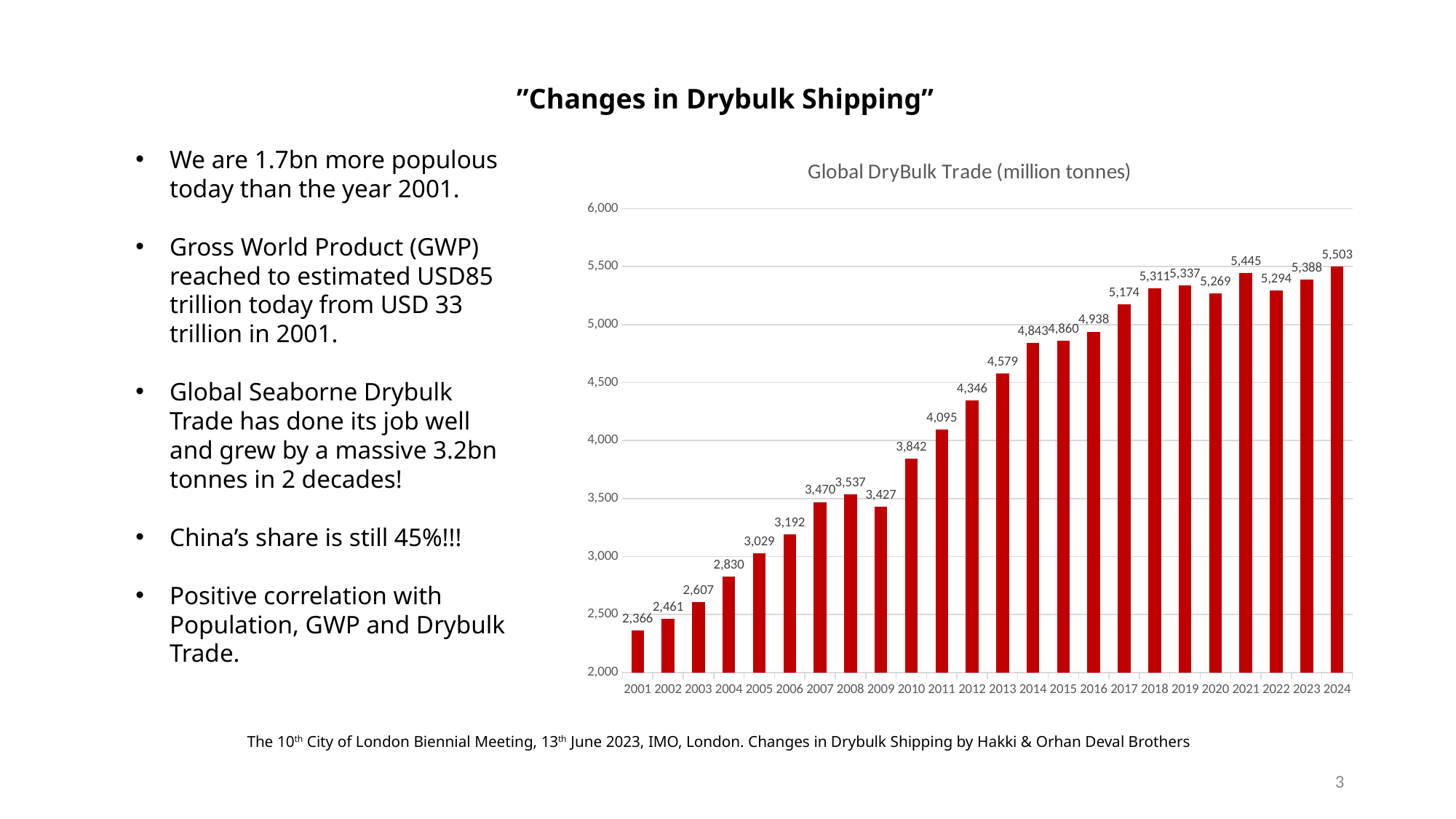
What is the title of the chart on the slide? Global DryBulk Trade (million tonnes) Which is larger in the Global DryBulk Trade chart, the value for 2019 or the value for 2020? 2019 What is the value for 2001 in the Global DryBulk Trade chart? 2,366 What is the difference between the 2024 and 2001 values in the Global DryBulk Trade chart? 3,137 Which year has the highest value in the Global DryBulk Trade chart? 2024 By how much did the value fall from 2008 to 2009 in the Global DryBulk Trade chart? 110 How many years are shown on the x axis of the Global DryBulk Trade chart? 24 What kind of chart is used to show Global DryBulk Trade? bar chart What is the value for 2009 in the Global DryBulk Trade chart? 3,427 Which year has the lowest value in the Global DryBulk Trade chart? 2001 What is the value for 2024 in the Global DryBulk Trade chart? 5,503 Is the value for 2017 in the Global DryBulk Trade chart greater or less than 5,000? greater